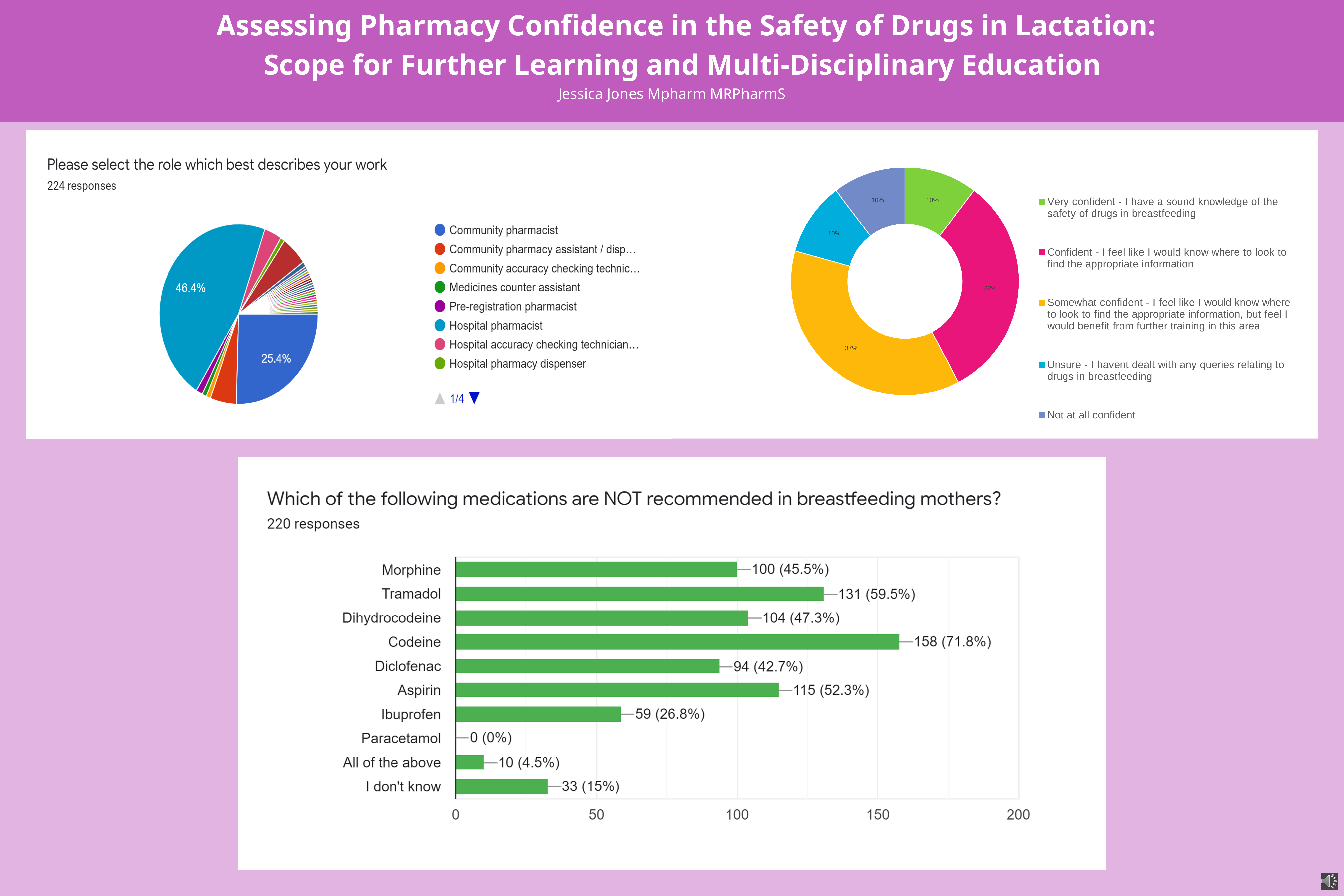
In the donut chart on the right of the top panel, what share is shown for 'Somewhat confident'? 37% In the bar chart 'Which of the following medications are NOT recommended in breastfeeding mothers?', which has more responses, Aspirin or Diclofenac? Aspirin How many entries does the legend of the donut chart on the right of the top panel list? 5 In the bar chart 'Which of the following medications are NOT recommended in breastfeeding mothers?', what is the value shown for Ibuprofen? 59 (26.8%) In the pie chart 'Please select the role which best describes your work', what percentage is shown for Hospital pharmacist? 46.4% How many categories are shown in the bar chart 'Which of the following medications are NOT recommended in breastfeeding mothers?'? 10 In the donut chart on the right of the top panel, which category has the largest share? Somewhat confident What kind of chart is used for 'Which of the following medications are NOT recommended in breastfeeding mothers?'? Bar chart In the bar chart 'Which of the following medications are NOT recommended in breastfeeding mothers?', what is the value shown for Codeine? 158 (71.8%) In the bar chart 'Which of the following medications are NOT recommended in breastfeeding mothers?', which medication has the highest number of responses? Codeine In the bar chart 'Which of the following medications are NOT recommended in breastfeeding mothers?', what is the difference in response counts between Tramadol and Morphine? 31 In the bar chart 'Which of the following medications are NOT recommended in breastfeeding mothers?', which category has the lowest value? Paracetamol